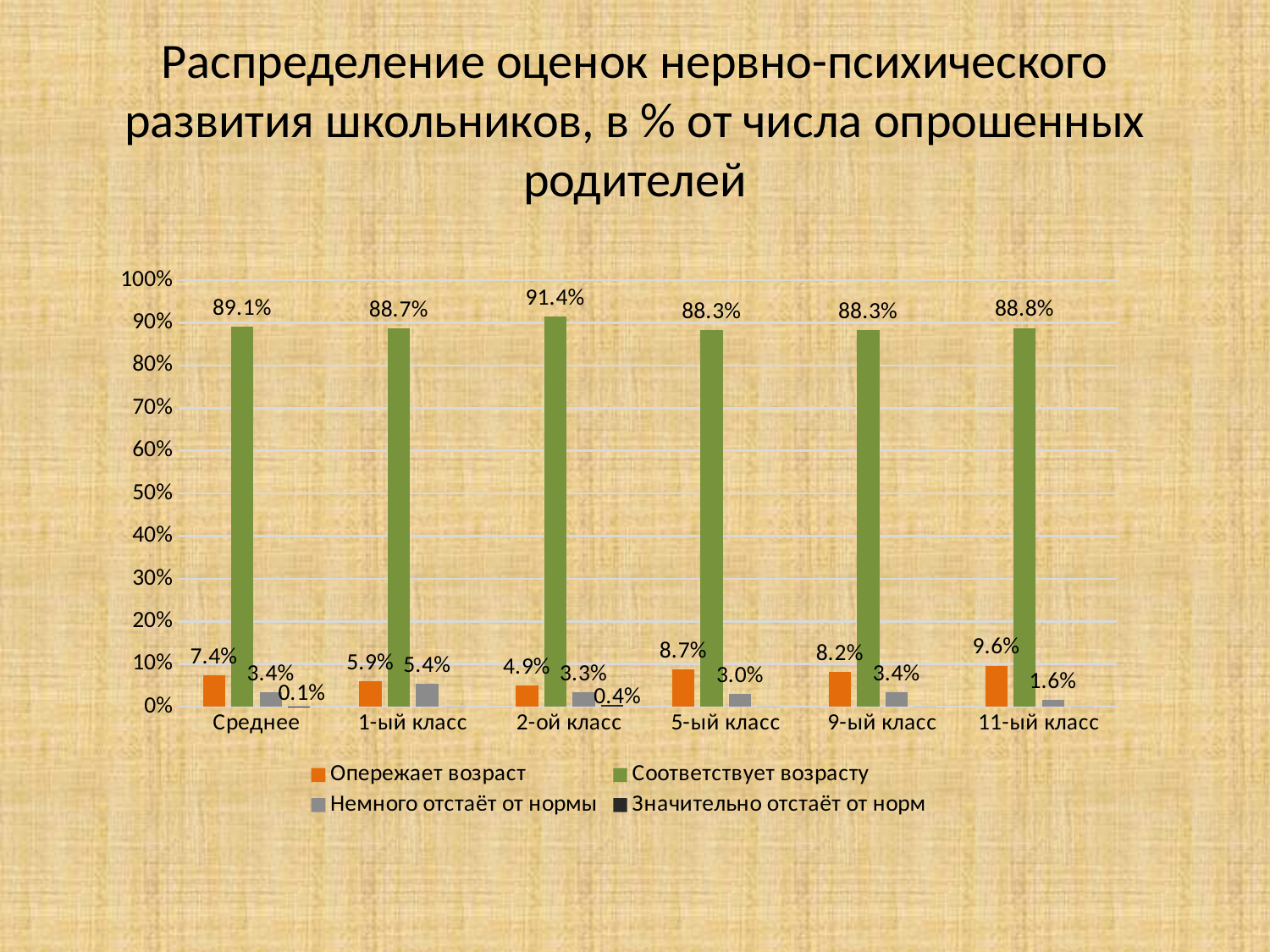
What is the value of "Соответствует возрасту" for 2-ой класс? 91.4% How many categories are shown on the x axis? 6 How many series does the legend list? 4 What is the value of "Опережает возраст" for 11-ый класс? 9.6% Which is larger: the "Немного отстаёт от нормы" value for 1-ый класс or for 11-ый класс? 1-ый класс What is the value of "Немного отстаёт от нормы" for 1-ый класс? 5.4% Which category has the highest value for "Соответствует возрасту"? 2-ой класс What is the value of "Значительно отстаёт от норм" for Среднее? 0.1% Which category has the lowest value for "Опережает возраст"? 2-ой класс Is the "Соответствует возрасту" value for 5-ый класс greater or less than 80%? greater What is the difference between the "Опережает возраст" values for 11-ый класс and 1-ый класс? 3.7% What kind of chart is shown on the slide? bar chart